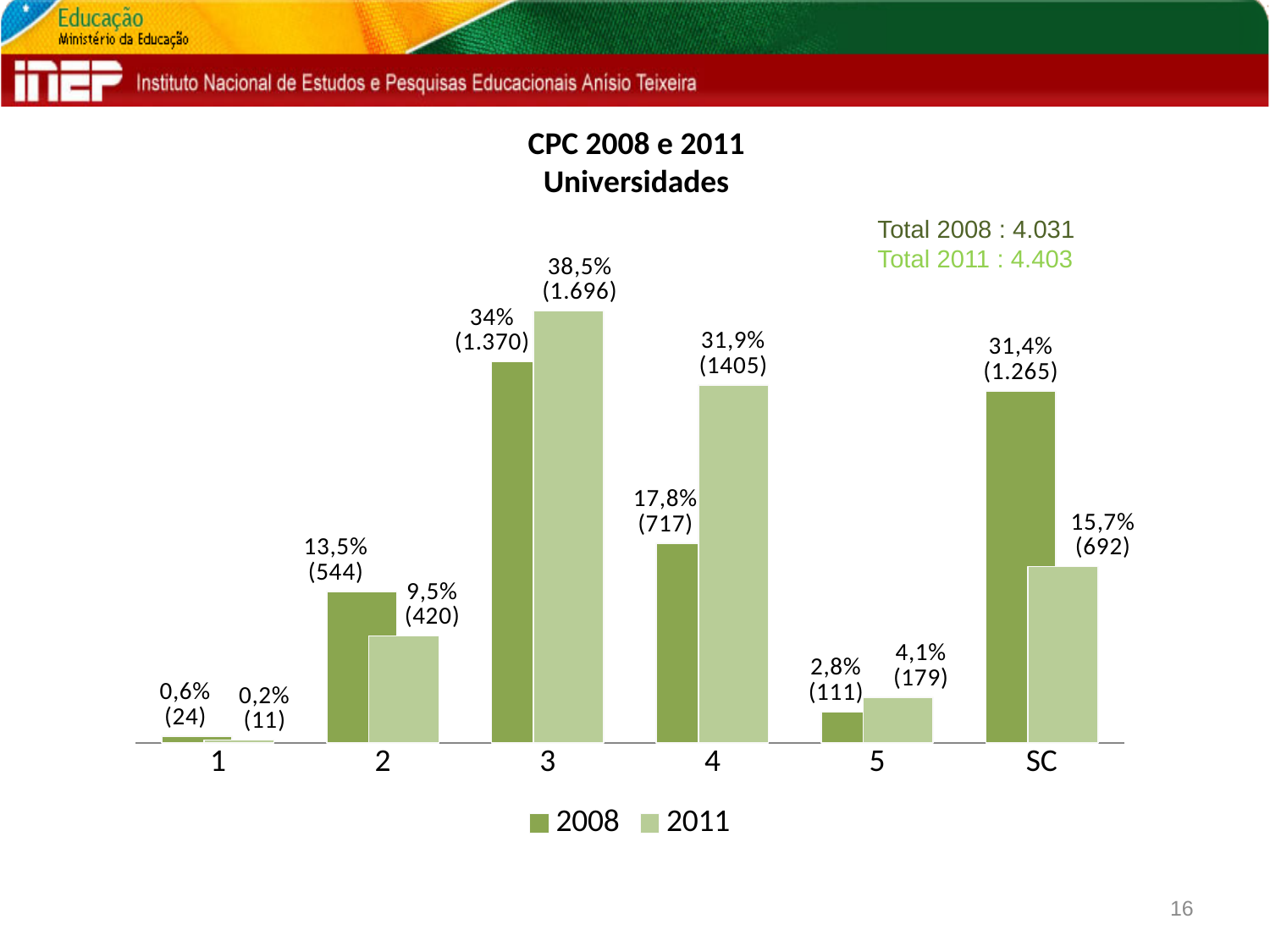
What kind of chart is shown on the slide? bar chart Which category has the highest value in the 2008 series? 3 What is the total for 2011 shown on the slide? 4.403 How many series does the legend list? 2 What is the value for category 3 in the 2011 series? 38,5% Which category has the lowest value in the 2011 series? 1 How many categories are shown on the x axis? 6 What is the title of the chart? CPC 2008 e 2011 Universidades Which is larger for category SC: the 2008 value or the 2011 value? 2008 What is the count shown in parentheses for category 4 in the 2011 series? 1405 What is the difference in percentage points between the 2011 and 2008 values for category 4? 14,1 What is the value for category SC in the 2008 series? 31,4%